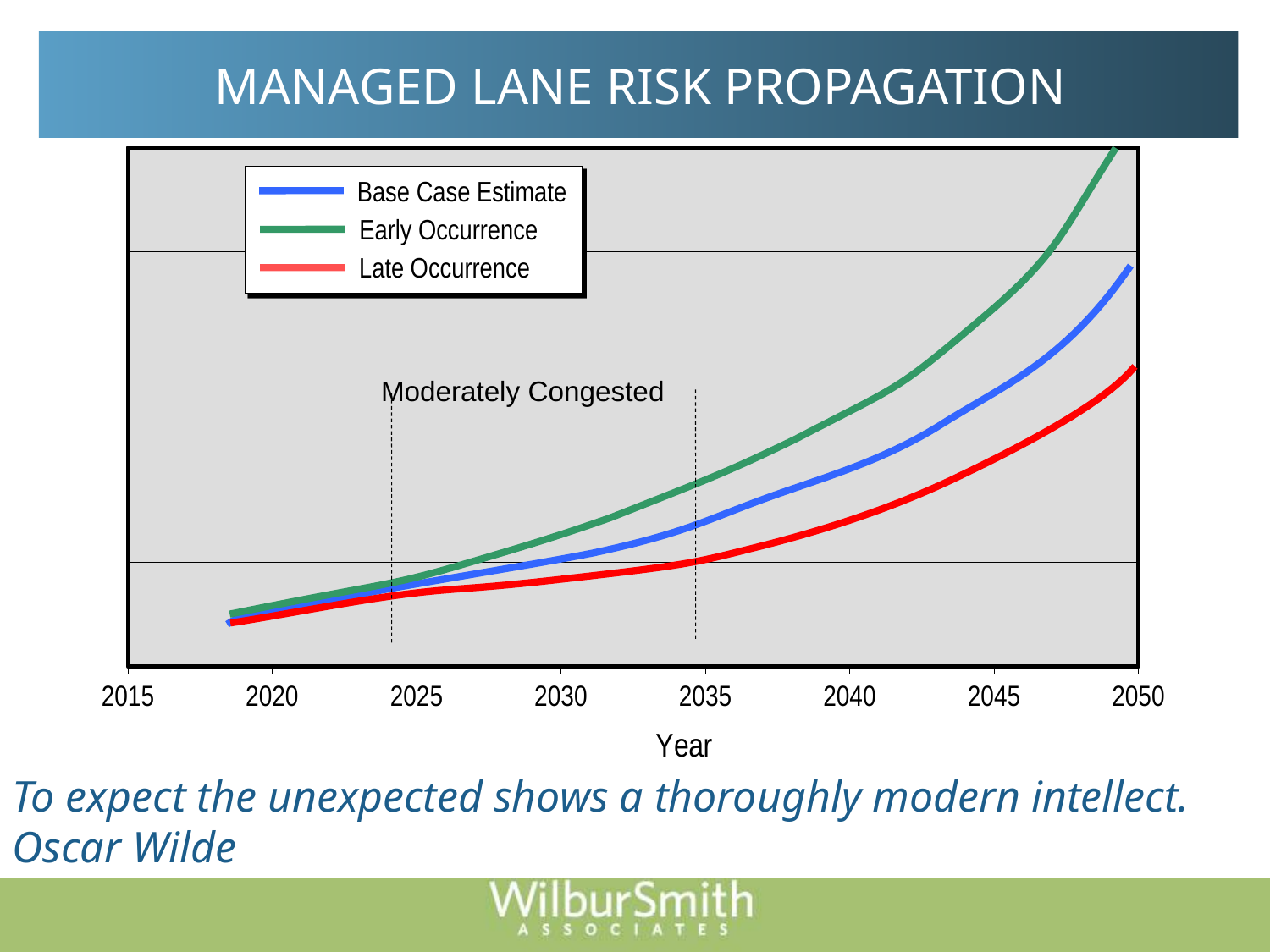
What is the first year labelled on the x axis? 2015 How many series does the legend list? 3 What kind of chart is shown on the slide? Line chart Which series has the highest value at the right end of the chart (around 2050)? Early Occurrence Around 2040, which series is lower: Base Case Estimate or Late Occurrence? Late Occurrence Do the values of the Late Occurrence series rise or fall from 2020 to 2050? Rise What is the title of the chart? MANAGED LANE RISK PROPAGATION What colour is the line for the Late Occurrence series? Red Do the values of the Base Case Estimate series rise or fall as the year increases? Rise What is the label of the x axis? Year Around 2045, which series is higher: Early Occurrence or Base Case Estimate? Early Occurrence Which series has the lowest value at the right end of the chart (around 2050)? Late Occurrence